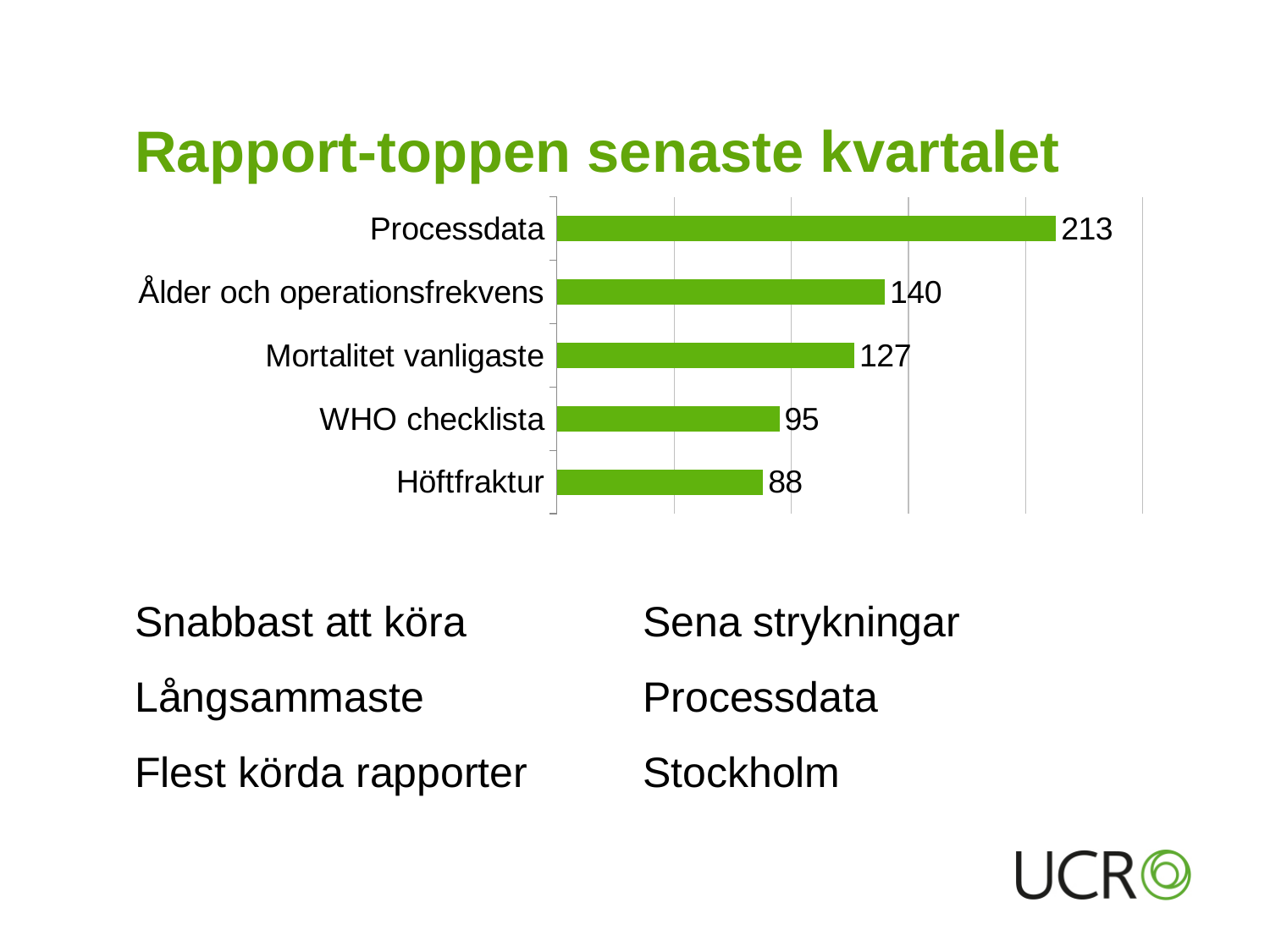
Which category has the highest value? Processdata How many categories are shown in the chart? 5 What is the difference between the values for Mortalitet vanligaste and WHO checklista? 32 What kind of chart is shown on the slide? Bar chart What is the value for Processdata? 213 Which is larger, the value for Mortalitet vanligaste or the value for Höftfraktur? Mortalitet vanligaste What is the title of the slide containing the chart? Rapport-toppen senaste kvartalet What is the difference between the values for Processdata and Ålder och operationsfrekvens? 73 What is the value for Ålder och operationsfrekvens? 140 What is the value for Höftfraktur? 88 What is the value for WHO checklista? 95 Which category has the lowest value? Höftfraktur